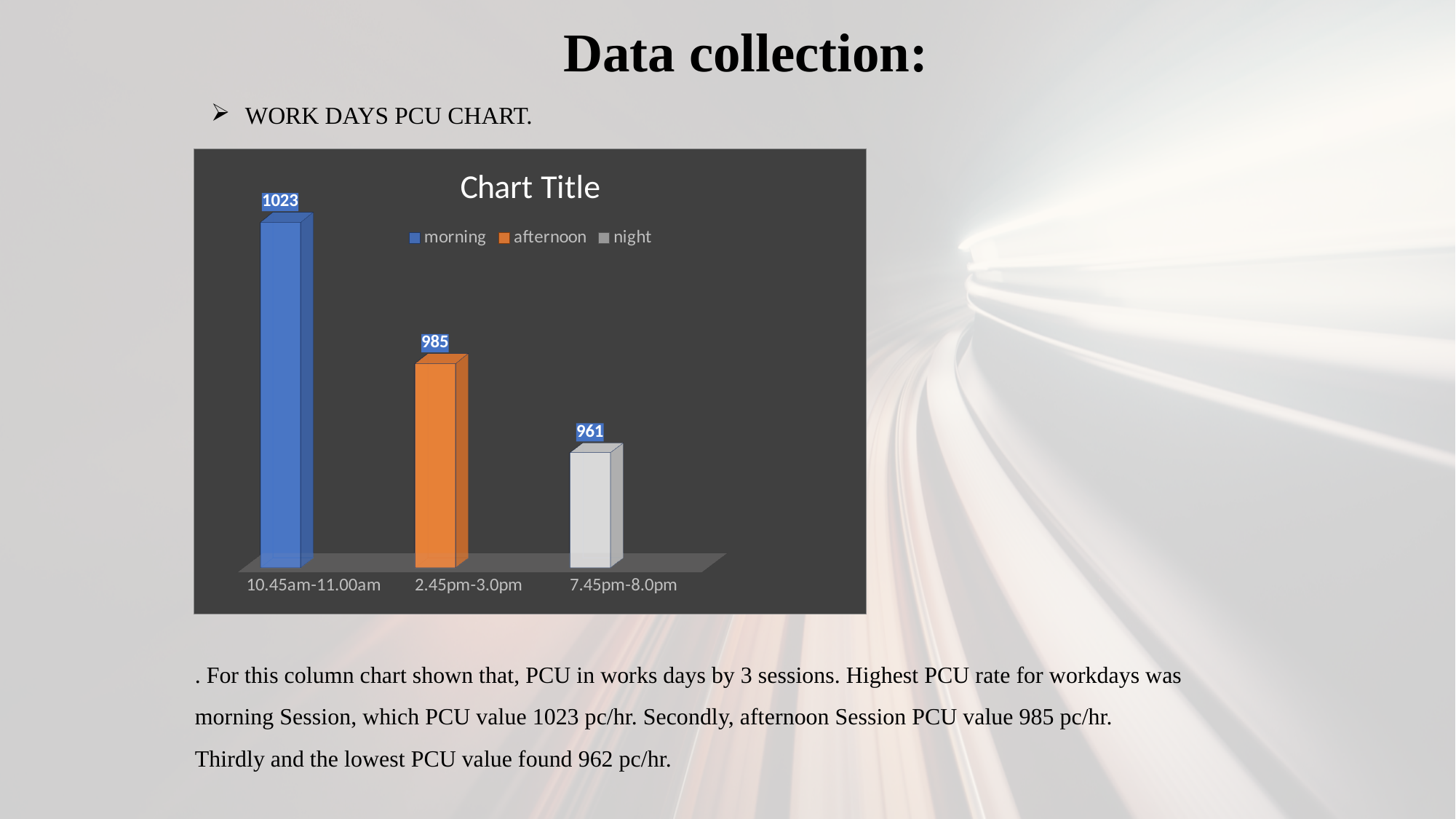
What is the value for the 10.45am-11.00am bar? 1023 Which category has the lowest value? 7.45pm-8.0pm Which is larger, the value for 10.45am-11.00am or the value for 7.45pm-8.0pm? 10.45am-11.00am What is the value for the 2.45pm-3.0pm bar? 985 How many series does the legend list? 3 Which category has the highest value? 10.45am-11.00am What is the value for the 7.45pm-8.0pm bar? 961 How many categories are shown on the x axis? 3 What kind of chart is shown? bar chart Do the values rise or fall from left to right along the x axis? fall What is the difference between the 2.45pm-3.0pm value and the 7.45pm-8.0pm value? 24 What is the difference between the 10.45am-11.00am value and the 2.45pm-3.0pm value? 38